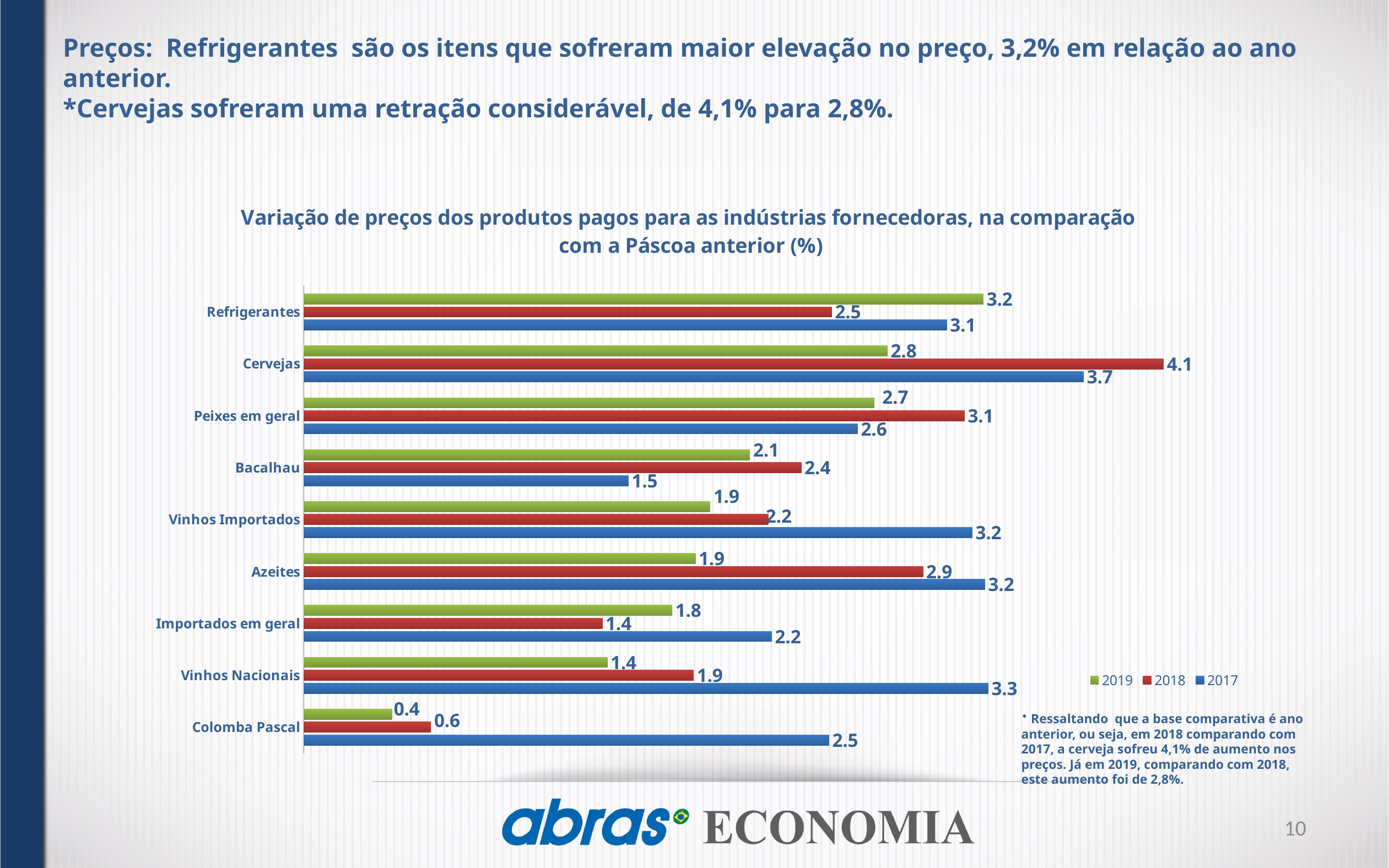
Which colour represents the 2018 series in the legend? Red What is the 2018 value for Cervejas? 4.1 How many product categories are shown on the chart? 9 Which is larger for Vinhos Nacionais, the 2017 value or the 2019 value? 2017 What is the 2019 value for Refrigerantes? 3.2 What is the 2019 value for Bacalhau? 2.1 Which category has the highest 2019 value? Refrigerantes Which category has the lowest 2018 value? Colomba Pascal What kind of chart is shown on the slide? Bar chart What is the difference between the 2018 and 2019 values for Cervejas? 1.3 What is the 2017 value for Colomba Pascal? 2.5 How many series does the legend list? 3